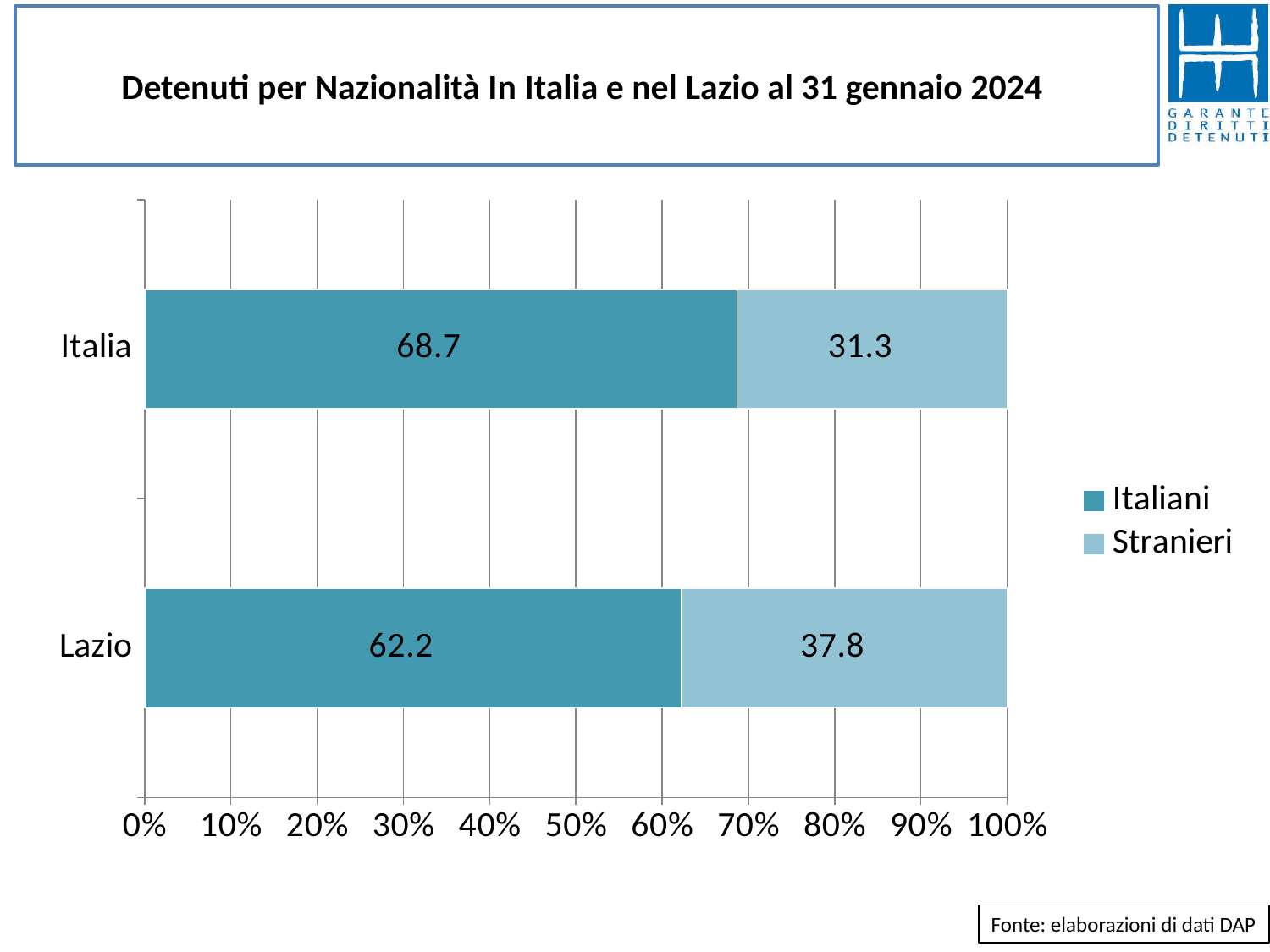
Which category has the higher value for Italiani, Italia or Lazio? Italia What is the value for Italiani in Italia? 68.7 What is the value for Stranieri in Lazio? 37.8 What is the value for Italiani in Lazio? 62.2 Which category has the higher value for Stranieri, Italia or Lazio? Lazio How many series does the legend list? 2 How many categories are shown on the chart? 2 What is the difference between the Stranieri values for Lazio and Italia? 6.5 What is the title of the chart? Detenuti per Nazionalità In Italia e nel Lazio al 31 gennaio 2024 What is the value for Stranieri in Italia? 31.3 What is the difference between the Italiani values for Italia and Lazio? 6.5 What kind of chart is shown on the slide? Stacked bar chart